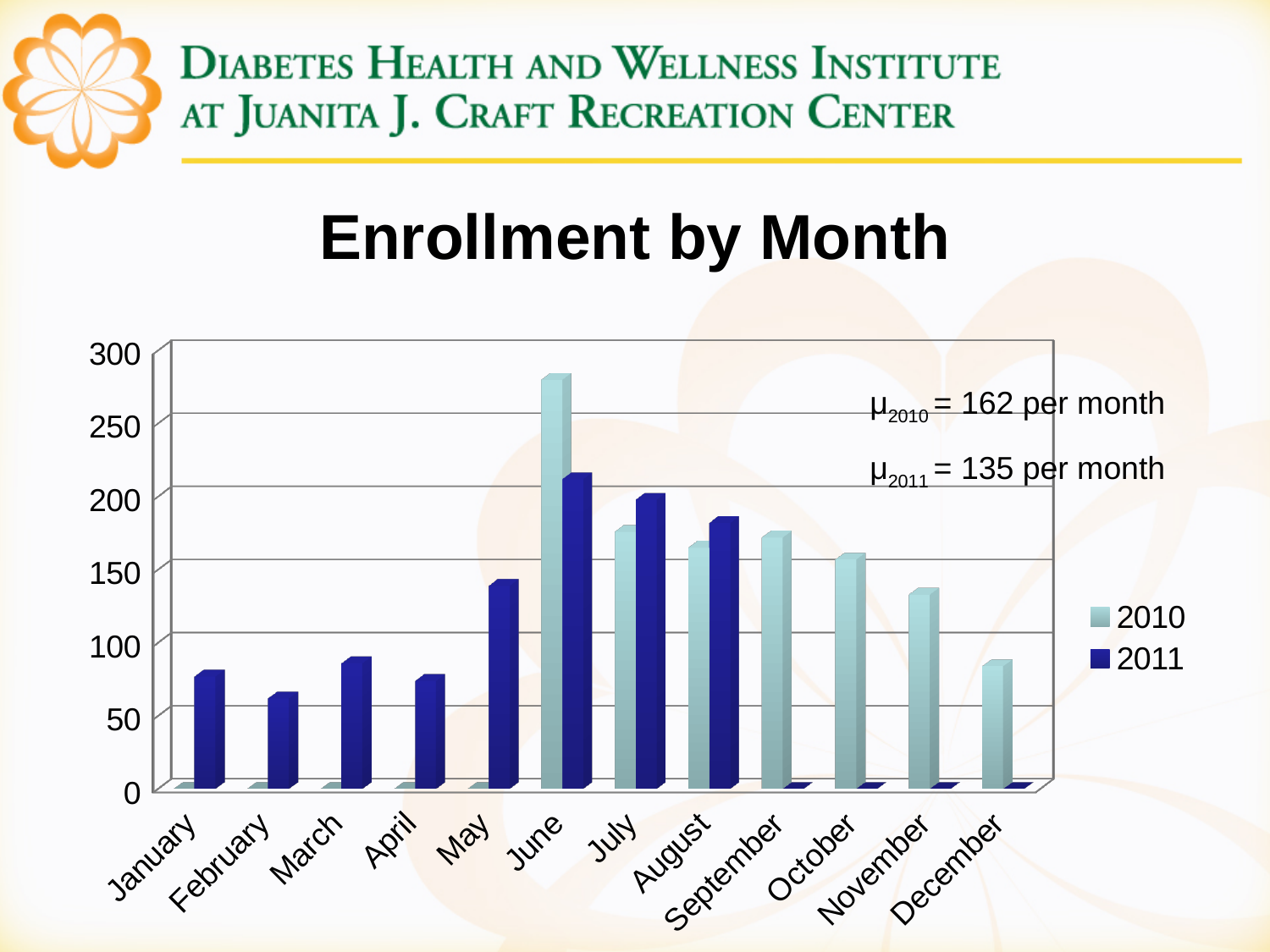
Which is larger, the 2010 enrollment for June or the 2011 enrollment for June? 2010 Is the 2011 enrollment for June greater or less than 200? greater Is the 2011 enrollment for February greater or less than 100? less How many months are shown on the x axis? 12 Do the 2010 enrollment values rise or fall from June to December? fall What kind of chart is shown on the slide? bar chart Which month has the highest enrollment for 2010? June Is the 2010 enrollment for June greater or less than 250? greater What is the title of the chart? Enrollment by Month How many series does the legend list? 2 According to the annotation on the chart, what is the average monthly enrollment for 2010? 162 per month Which month has the highest enrollment for 2011? June